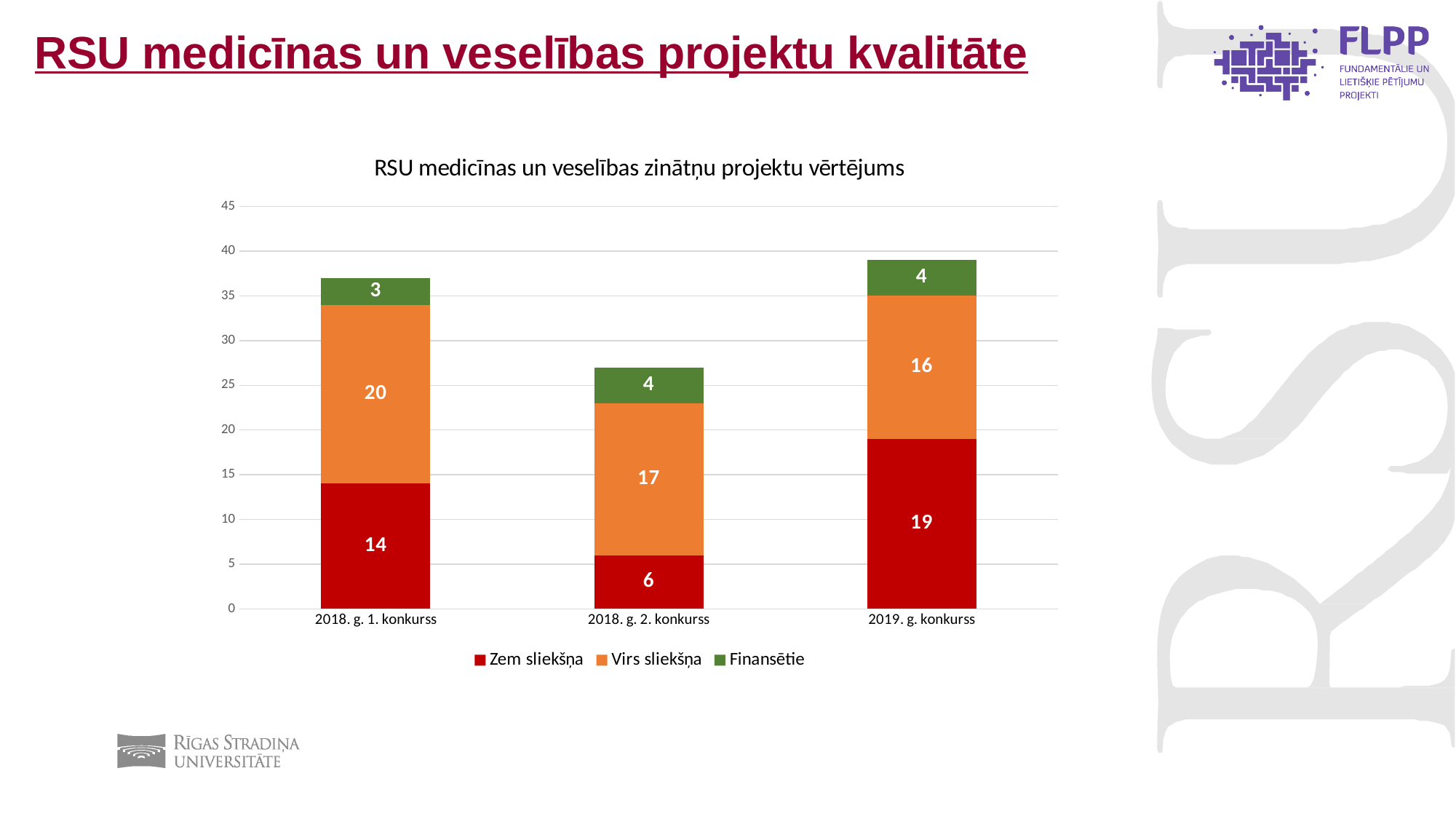
Which category has the highest Zem sliekšņa value? 2019. g. konkurss What is the value of Finansētie for 2019. g. konkurss? 4 What is the total of the stacked bar for 2019. g. konkurss? 39 What is the value of Virs sliekšņa for 2018. g. 2. konkurss? 17 What kind of chart is shown on the slide? Stacked bar chart What is the difference between the Virs sliekšņa values for 2018. g. 1. konkurss and 2019. g. konkurss? 4 What is the total of the stacked bar for 2018. g. 2. konkurss? 27 How many categories are shown on the x axis? 3 Which category has the lowest Finansētie value? 2018. g. 1. konkurss How many series does the legend list? 3 What is the value of Zem sliekšņa for 2018. g. 1. konkurss? 14 Which is larger: Zem sliekšņa for 2018. g. 2. konkurss or Zem sliekšņa for 2018. g. 1. konkurss? 2018. g. 1. konkurss